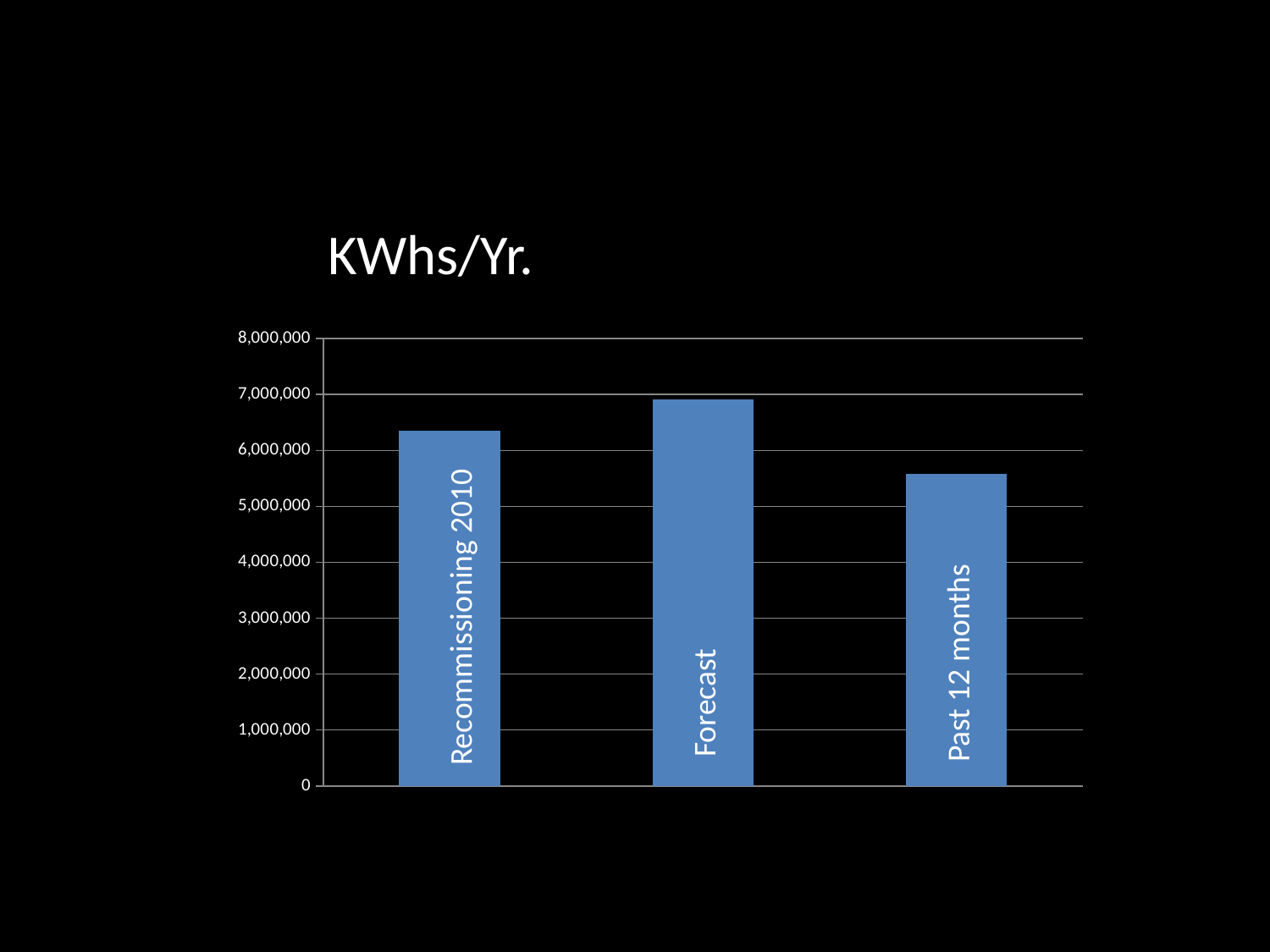
Is the value for Past 12 months greater or less than 5,000,000? greater Is the value for Forecast greater or less than 7,000,000? less Is the value for Recommissioning 2010 greater or less than 6,000,000? greater Which is larger, the value for Forecast or the value for Recommissioning 2010? Forecast What kind of chart is shown on the slide? bar chart How many bars are plotted in the chart? 3 Which category has the lowest value? Past 12 months What is the title of the chart? KWhs/Yr. Which category has the highest value? Forecast What is the highest value shown on the vertical axis? 8,000,000 Which is larger, the value for Recommissioning 2010 or the value for Past 12 months? Recommissioning 2010